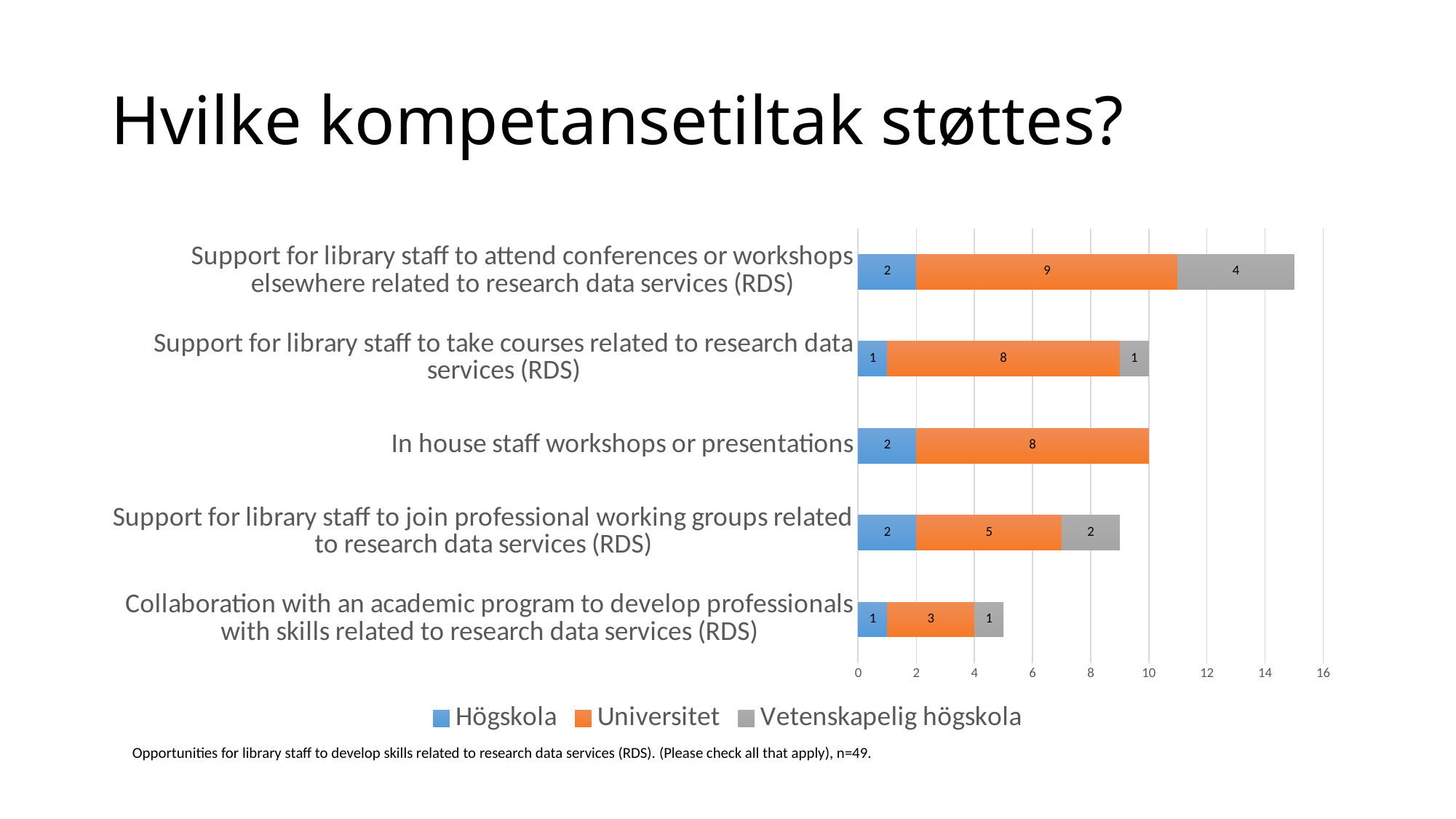
What kind of chart is shown on the slide? Stacked bar chart What is the Högskola value for 'Support for library staff to take courses related to research data services (RDS)'? 1 What is the difference between the Universitet values for 'Support for library staff to attend conferences or workshops elsewhere related to research data services (RDS)' and 'Support for library staff to join professional working groups related to research data services (RDS)'? 4 What is the Vetenskapelig högskola value for 'Support for library staff to join professional working groups related to research data services (RDS)'? 2 Which category has the highest total across all series? Support for library staff to attend conferences or workshops elsewhere related to research data services (RDS) What is the total of the stacked bar for 'Collaboration with an academic program to develop professionals with skills related to research data services (RDS)'? 5 Which series is shown in orange in the legend? Universitet How many series does the legend list? 3 How many categories are plotted on the chart? 5 What is the total of the stacked bar for 'Support for library staff to attend conferences or workshops elsewhere related to research data services (RDS)'? 15 Which category has the lowest total across all series? Collaboration with an academic program to develop professionals with skills related to research data services (RDS) What is the Universitet value for 'Support for library staff to attend conferences or workshops elsewhere related to research data services (RDS)'? 9